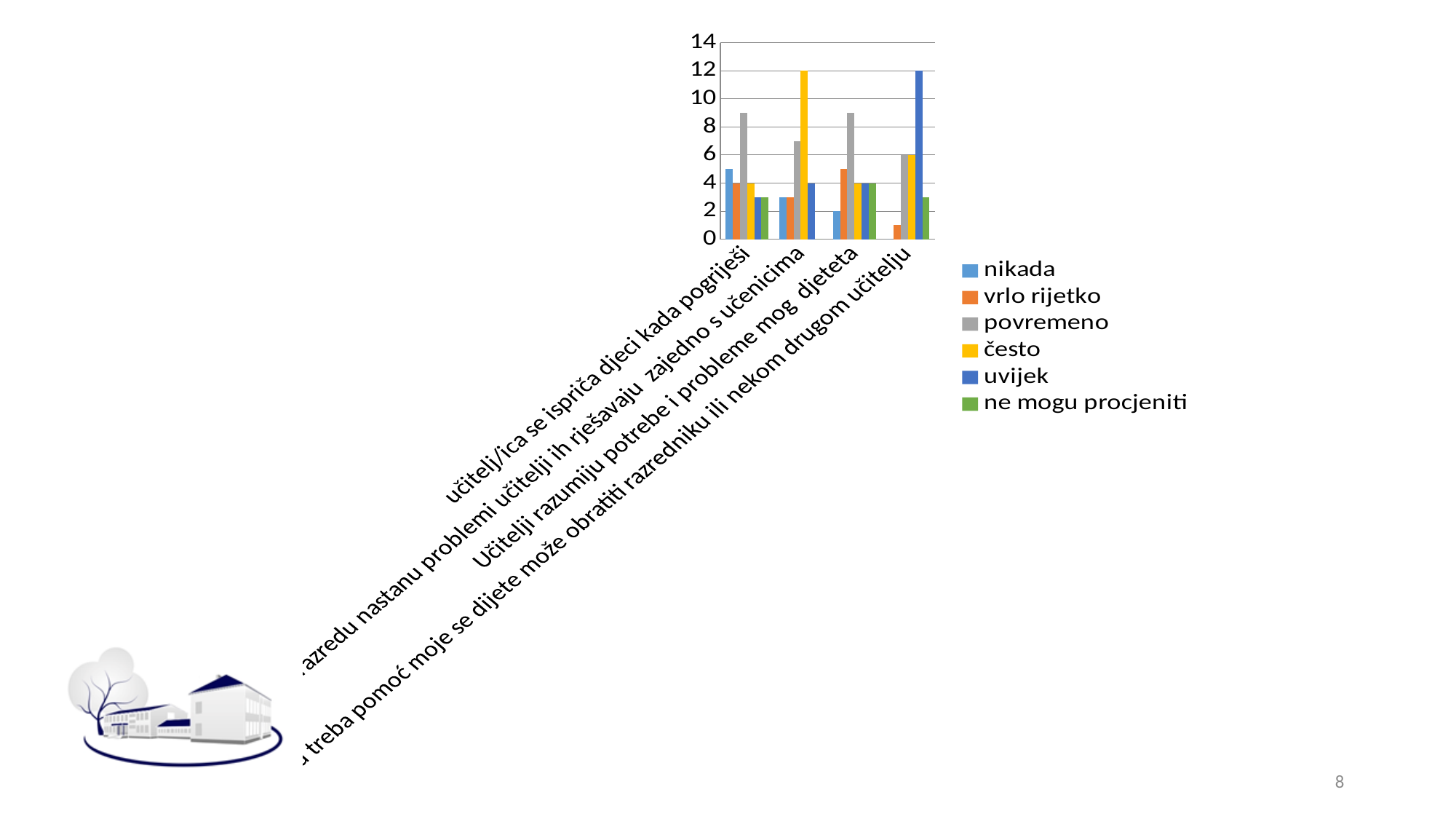
How many categories are shown on the x axis of the chart? 4 What is the value for "uvijek" in the category "...može obratiti razredniku ili nekom drugom učitelju"? 12 How many series does the legend list? 6 What kind of chart is shown on the slide? bar chart What is the value for "uvijek" in the category "...učitelji ih rješavaju zajedno s učenicima"? 4 Which series has the highest value in the category "...može obratiti razredniku ili nekom drugom učitelju"? uvijek What is the value for "često" in the category "...učitelji ih rješavaju zajedno s učenicima"? 12 Is the value for "povremeno" in the category "Učitelji razumiju potrebe i probleme mog djeteta" greater or less than 8? greater What is the value for "nikada" in the category "Učitelji razumiju potrebe i probleme mog djeteta"? 2 What is the value for "povremeno" in the category "...može obratiti razredniku ili nekom drugom učitelju"? 6 In the category "...učitelji ih rješavaju zajedno s učenicima", which is larger: "često" or "povremeno"? često Which series has the highest value in the category "učitelj/ica se ispriča djeci kada pogriješi"? povremeno